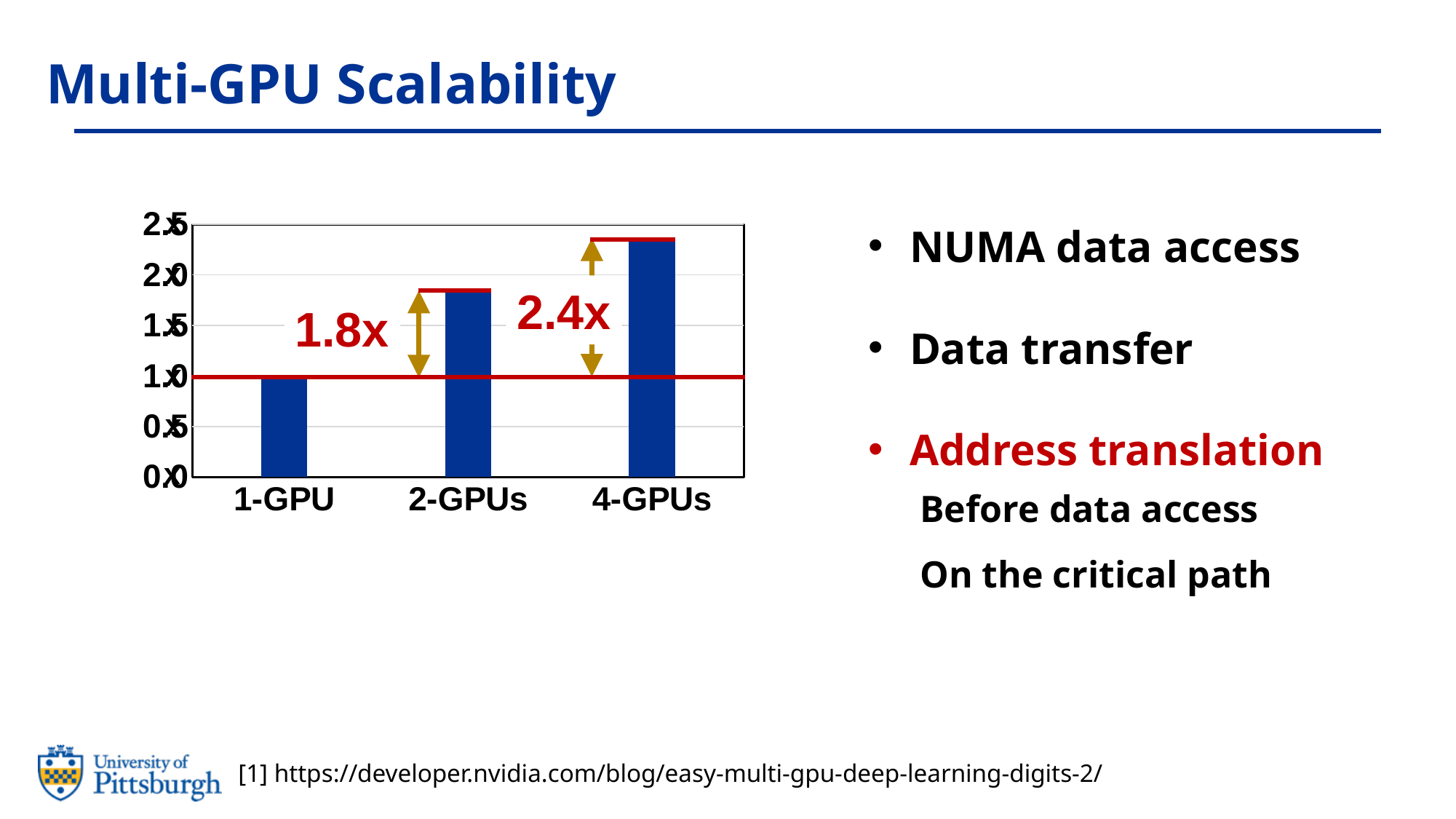
Which category has the lowest bar in the chart? 1-GPU What is the difference between the annotated speedups for 4-GPUs and 2-GPUs? 0.6x Which category has the highest bar in the chart? 4-GPUs What speedup is annotated for 2-GPUs in the chart? 1.8x Is the value for 2-GPUs greater or less than 1.5x? greater Do the bar values rise or fall from 1-GPU to 4-GPUs? rise What colour are the bars in the chart? blue Which is larger, the value for 2-GPUs or the value for 4-GPUs? 4-GPUs What value does the 1-GPU bar reach on the y axis? 1.0x What kind of chart is shown on the slide? bar chart What speedup is annotated for 4-GPUs in the chart? 2.4x How many categories are shown on the x axis of the chart? 3